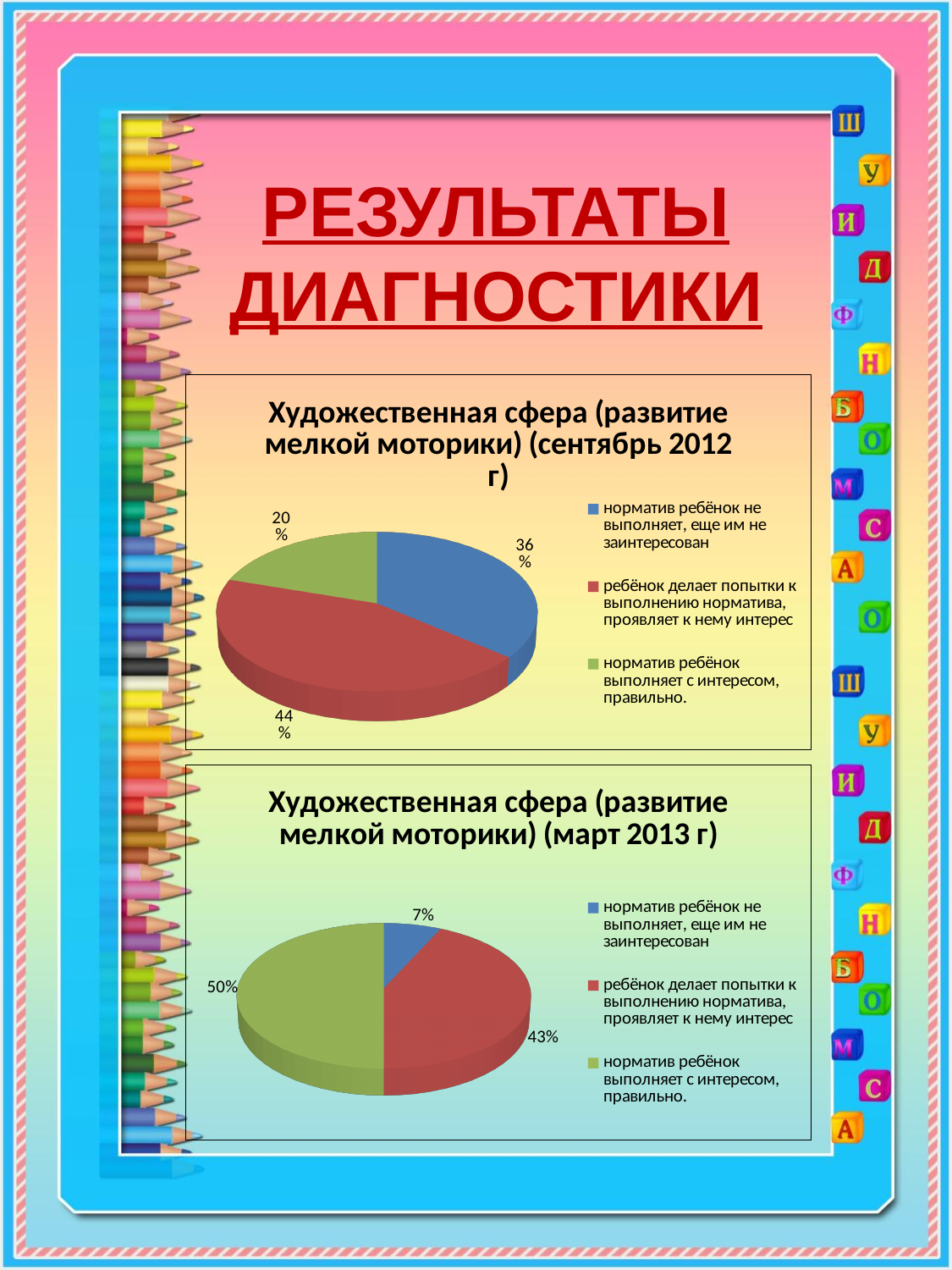
What type of chart is used in the top chart (сентябрь 2012)? pie chart In the top chart (сентябрь 2012), what share of children is in the category 'норматив ребёнок не выполняет, еще им не заинтересован'? 36% In the bottom chart (март 2013 г), what share is shown for 'норматив ребёнок выполняет с интересом, правильно'? 50% How many categories does the legend of the bottom chart (март 2013 г) list? 3 In the top chart (сентябрь 2012), what share is shown for 'ребёнок делает попытки к выполнению норматива, проявляет к нему интерес'? 44% In the bottom chart (март 2013 г), which category has the largest slice? норматив ребёнок выполняет с интересом, правильно What is the difference between the share for 'норматив ребёнок выполняет с интересом, правильно' in the bottom chart (март 2013 г) and in the top chart (сентябрь 2012)? 30% In the top chart (сентябрь 2012), which category has the smallest slice? норматив ребёнок выполняет с интересом, правильно In the bottom chart (март 2013 г), what share is shown for 'норматив ребёнок не выполняет, еще им не заинтересован'? 7% In the bottom chart (март 2013 г), which category has the smallest slice? норматив ребёнок не выполняет, еще им не заинтересован In the top chart (сентябрь 2012), what share is shown for 'норматив ребёнок выполняет с интересом, правильно'? 20% In the top chart (сентябрь 2012), which is larger: the share for 'норматив ребёнок не выполняет, еще им не заинтересован' or the share for 'ребёнок делает попытки к выполнению норматива, проявляет к нему интерес'? ребёнок делает попытки к выполнению норматива, проявляет к нему интерес